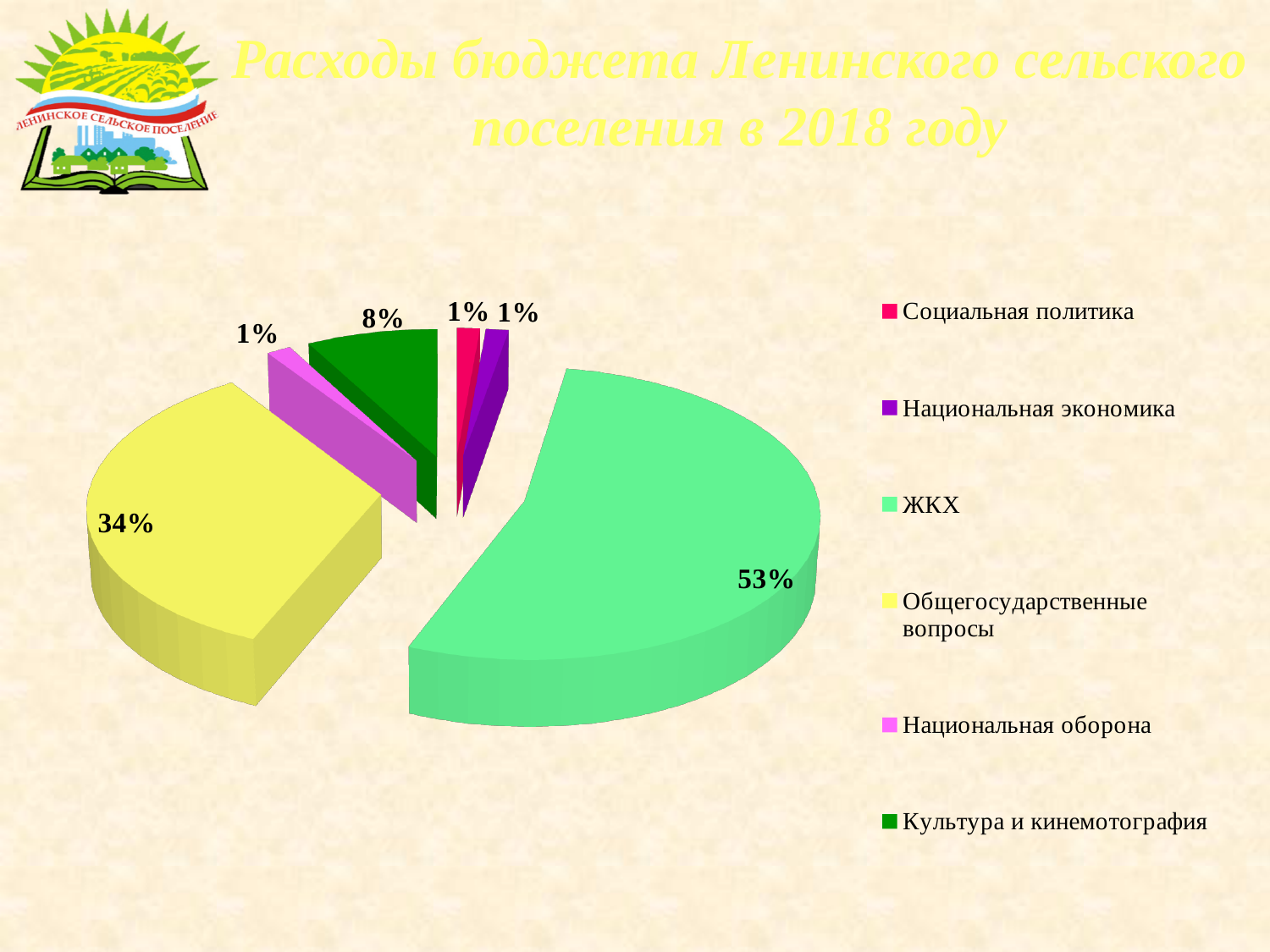
What is the title of the slide? Расходы бюджета Ленинского сельского поселения в 2018 году Which category has the largest slice of the pie? ЖКХ What share of the pie does ЖКХ have? 53% Which is larger, the slice for Общегосударственные вопросы or the slice for Культура и кинемотография? Общегосударственные вопросы How many categories does the legend list? 6 What share of the pie does Общегосударственные вопросы have? 34% What kind of chart is shown on the slide? pie chart What share of the pie does Национальная оборона have? 1% What is the difference in percentage points between the ЖКХ slice and the Общегосударственные вопросы slice? 19 Which colour represents Национальная экономика in the pie chart? purple What is the combined share of ЖКХ and Общегосударственные вопросы? 87%